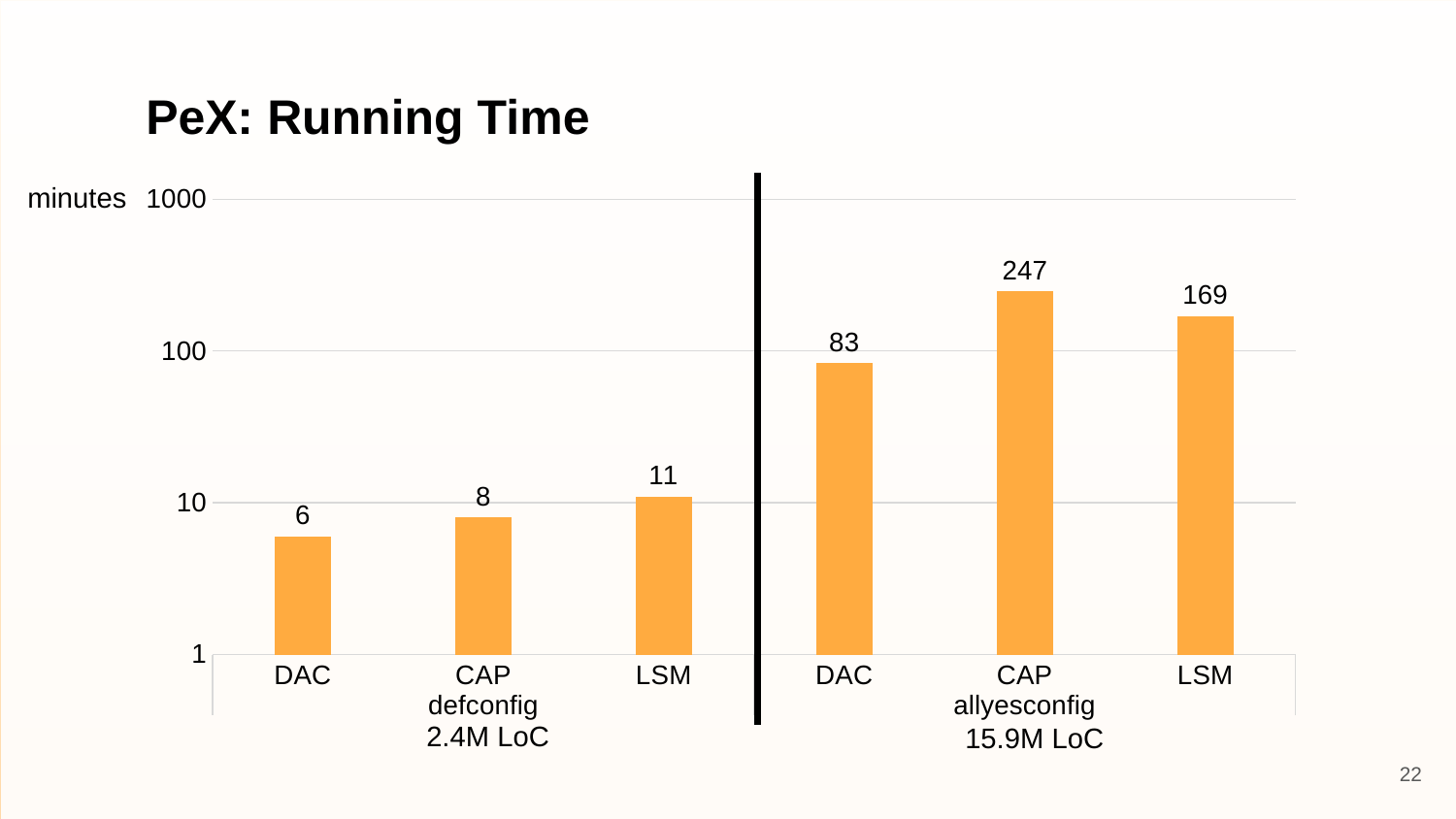
What kind of chart is shown on the slide? bar chart What is the running time for DAC under allyesconfig? 83 Which bar has the lowest value on the chart? DAC defconfig What is the running time for LSM under defconfig? 11 What unit is shown for the y axis of the chart? minutes What is the difference between the CAP and LSM running times under allyesconfig? 78 What is the difference between the DAC running times under allyesconfig and defconfig? 77 Is the value for CAP under defconfig greater or less than 10? less Which is larger, the LSM running time under allyesconfig or the DAC running time under allyesconfig? LSM allyesconfig What is the running time for CAP under allyesconfig? 247 How many bars are plotted on the chart? 6 Which bar has the highest value on the chart? CAP allyesconfig